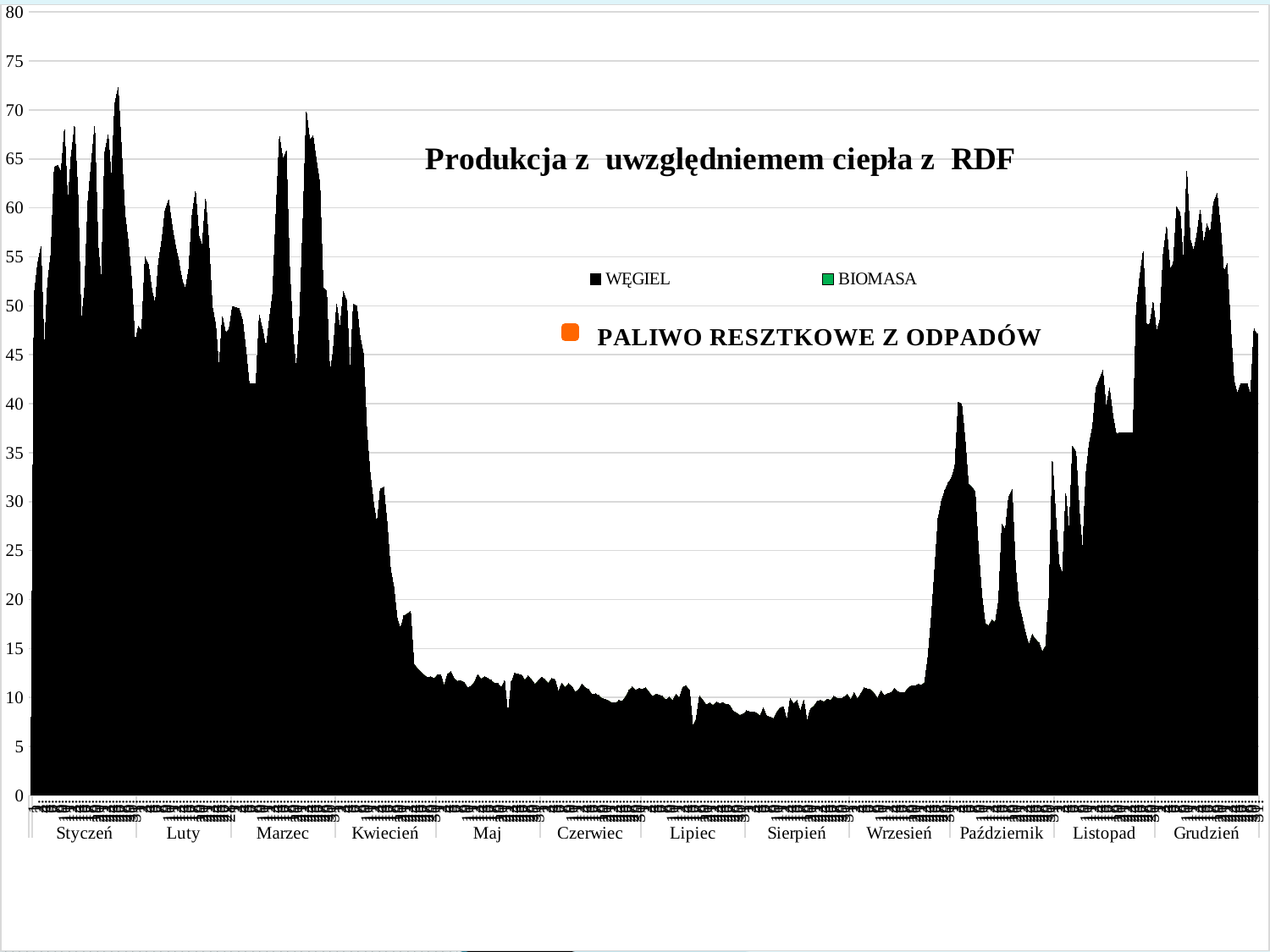
Are the values in Grudzień greater or less than 35? greater Which month has higher values, Styczeń or Lipiec? Styczeń Which series is shown in black in the legend? WĘGIEL Do the values rise or fall from Kwiecień to Maj? fall How many months are labelled along the x axis? 12 What is the title of the chart? Produkcja z uwzględniemem ciepła z RDF Are the values in Lipiec greater or less than 15? less How many series does the legend list? 3 Are the values in Czerwiec greater or less than 20? less What kind of chart is shown on the slide? Area chart Do the values rise or fall from Wrzesień to Grudzień? rise